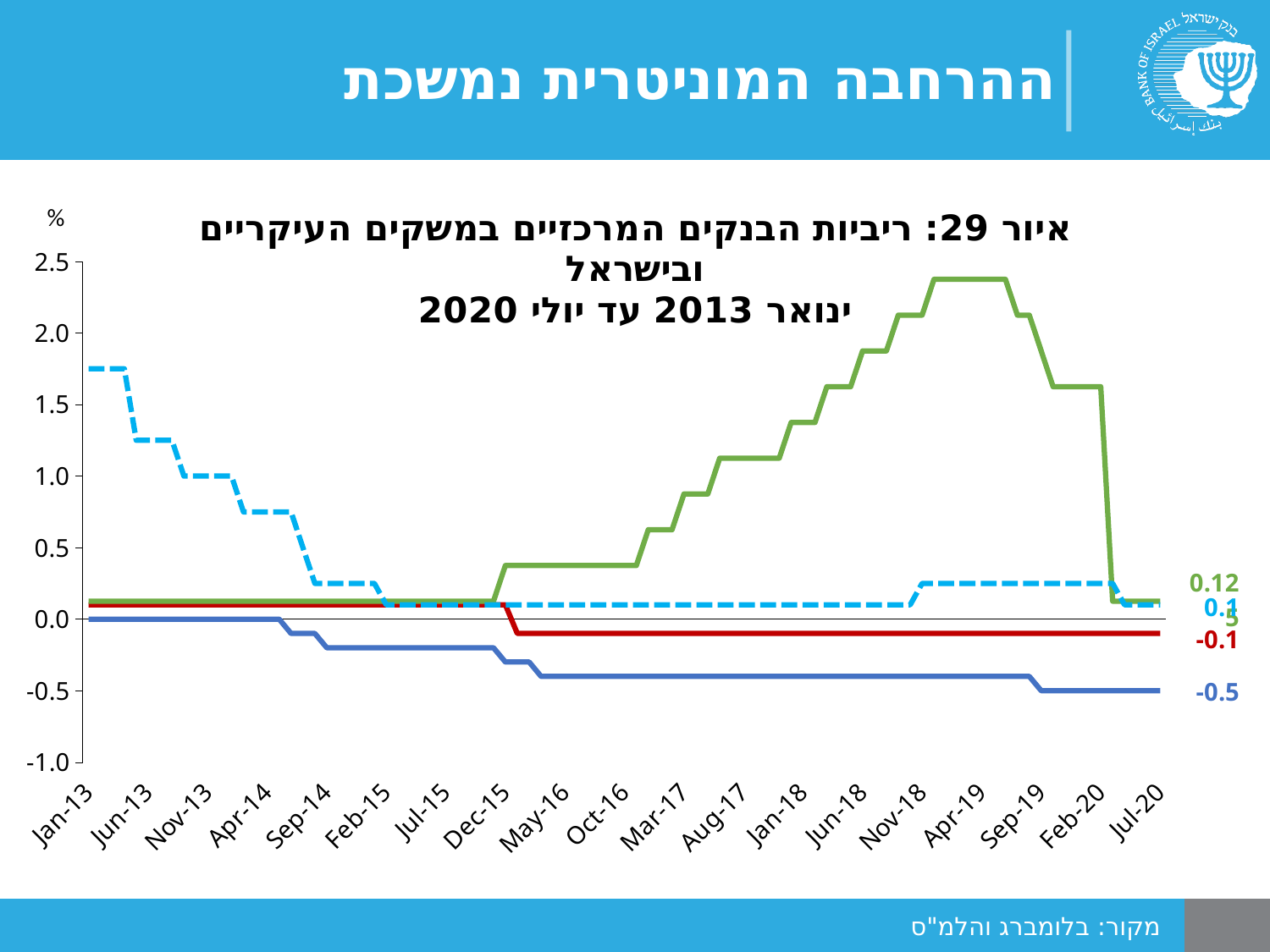
How many lines are plotted on the chart? 4 Which line reaches the highest value on the chart? the green line Which line has the lowest value at the end of the period (Jul-20)? the dark blue line What kind of chart is shown on the slide? line chart What is the final value labelled at the end of the dark blue line? -0.5 At Jul-20, which is larger: the value of the red line or the value of the dark blue line? the red line Does the green line rise or fall between Feb-20 and Jul-20? fall What unit is shown at the top of the y axis? % What is the final value labelled at the end of the red line? -0.1 Is the value of the light blue dashed line at Jan-13 greater or less than 1.5? greater Is the peak value of the green line greater or less than 2.0? greater Does the light blue dashed line rise or fall between Jan-13 and Feb-15? fall